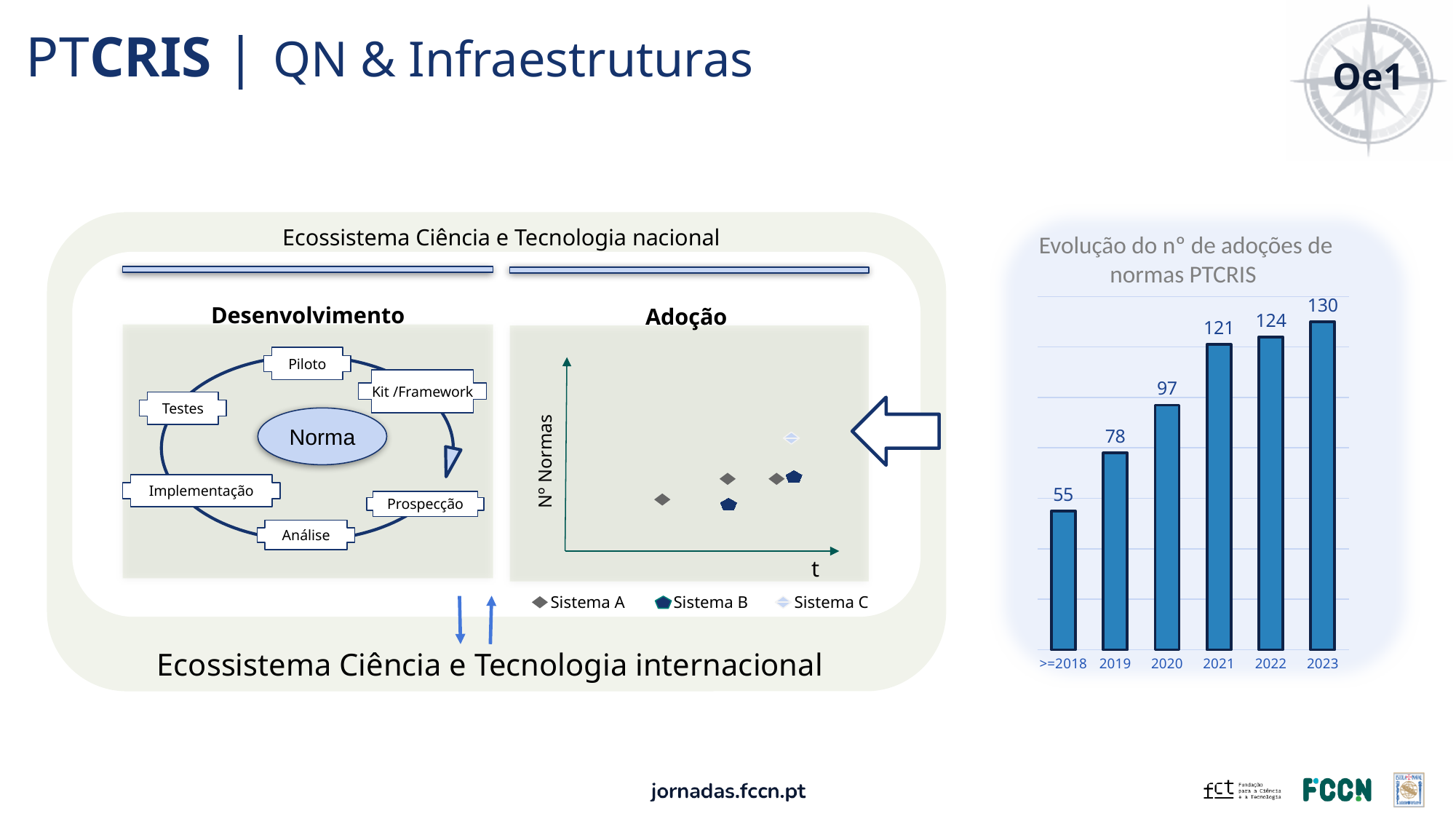
In the chart 'Evolução do nº de adoções de normas PTCRIS', which is larger, the value for 2019 or the value for 2020? 2020 How many bars are shown in the chart 'Evolução do nº de adoções de normas PTCRIS'? 6 In the chart 'Evolução do nº de adoções de normas PTCRIS', what is the value for 2020? 97 How many series does the legend of the 'Adoção' chart list? 3 In the chart 'Evolução do nº de adoções de normas PTCRIS', what is the value for >=2018? 55 In the chart 'Evolução do nº de adoções de normas PTCRIS', which category has the lowest value? >=2018 In the chart 'Evolução do nº de adoções de normas PTCRIS', which year has the highest value? 2023 In the chart 'Evolução do nº de adoções de normas PTCRIS', do the values rise or fall from >=2018 to 2023? rise In the chart 'Evolução do nº de adoções de normas PTCRIS', what is the difference between the values for 2021 and 2020? 24 In the chart 'Evolução do nº de adoções de normas PTCRIS', what is the value for 2022? 124 In the chart 'Evolução do nº de adoções de normas PTCRIS', what is the difference between the values for 2023 and 2019? 52 What kind of chart is 'Evolução do nº de adoções de normas PTCRIS'? bar chart